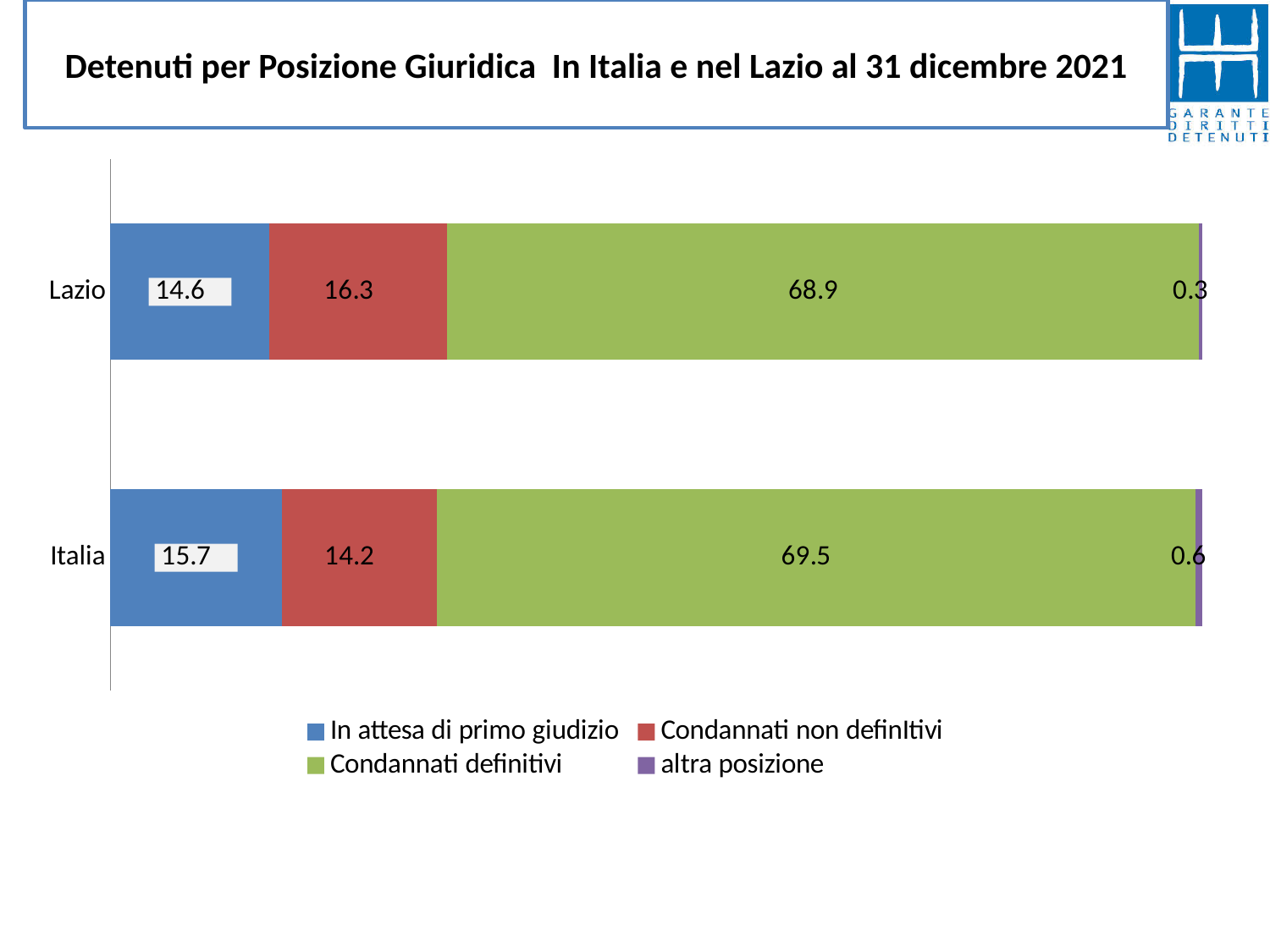
Which is larger, the 'In attesa di primo giudizio' value for Lazio or for Italia? Italia How many categories (bars) are shown in the chart? 2 Which series has the largest value in the Italia bar? Condannati definitivi What is the value for 'Condannati definitivi' for Lazio? 68.9 What is the value for 'Condannati non definitivi' for Lazio? 16.3 What is the total of the Italia stacked bar? 100.0 What is the value for 'altra posizione' for Italia? 0.6 Which series has the smallest value in the Lazio bar? altra posizione What is the value for 'In attesa di primo giudizio' for Italia? 15.7 How many series does the legend list? 4 What is the difference between the 'Condannati non definitivi' values for Lazio and Italia? 2.1 What kind of chart is shown on the slide? Stacked bar chart